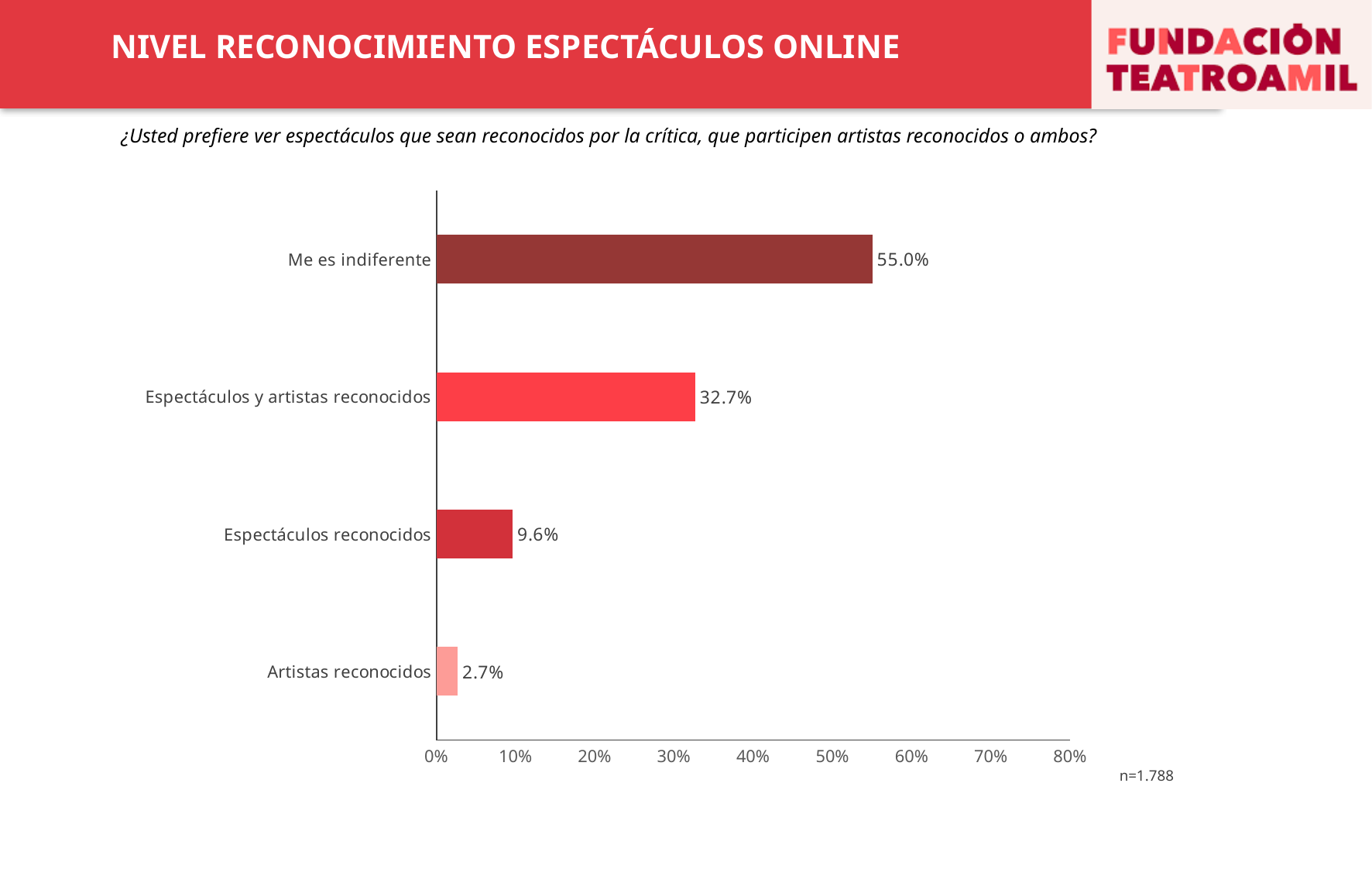
What is the difference between "Me es indiferente" and "Espectáculos y artistas reconocidos"? 22.3% What is the value for "Artistas reconocidos"? 2.7% What is the value for "Espectáculos reconocidos"? 9.6% What is the value for "Espectáculos y artistas reconocidos"? 32.7% Is the value for "Me es indiferente" greater or less than 50%? greater Which category has the lowest value? Artistas reconocidos Which category has the highest value? Me es indiferente How many categories are shown in the chart? 4 What kind of chart is shown on the slide? Bar chart What is the value for "Me es indiferente"? 55.0% What is the difference between "Espectáculos reconocidos" and "Artistas reconocidos"? 6.9% Which is larger, "Espectáculos reconocidos" or "Artistas reconocidos"? Espectáculos reconocidos